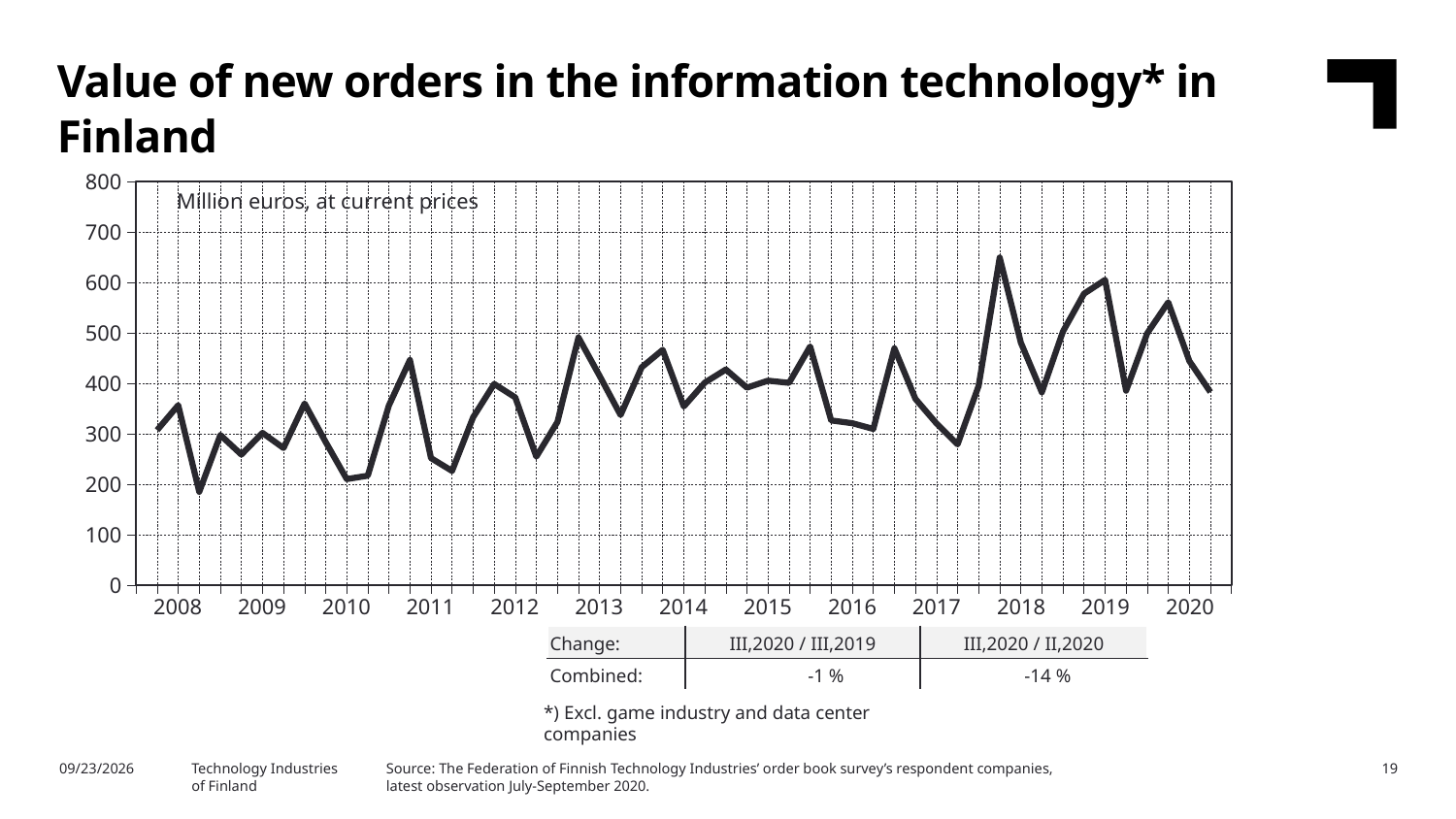
Is the highest peak of the line, in 2018, greater or less than 600? greater In what unit are the values on the chart expressed? Million euros, at current prices In which year does the line reach its lowest point? 2008 In which year does the line reach its highest peak? 2018 Is the lowest point of the line, in 2008, greater or less than 300? less How many years are labelled on the x axis? 13 What is the combined change for III,2020 / III,2019 shown in the table below the chart? -1 % What is the title of the chart? Value of new orders in the information technology* in Finland What is the combined change for III,2020 / II,2020 shown in the table below the chart? -14 % Is the last plotted value, in 2020, greater or less than 300? greater What is the maximum value shown on the y axis? 800 What kind of chart is shown on the slide? Line chart